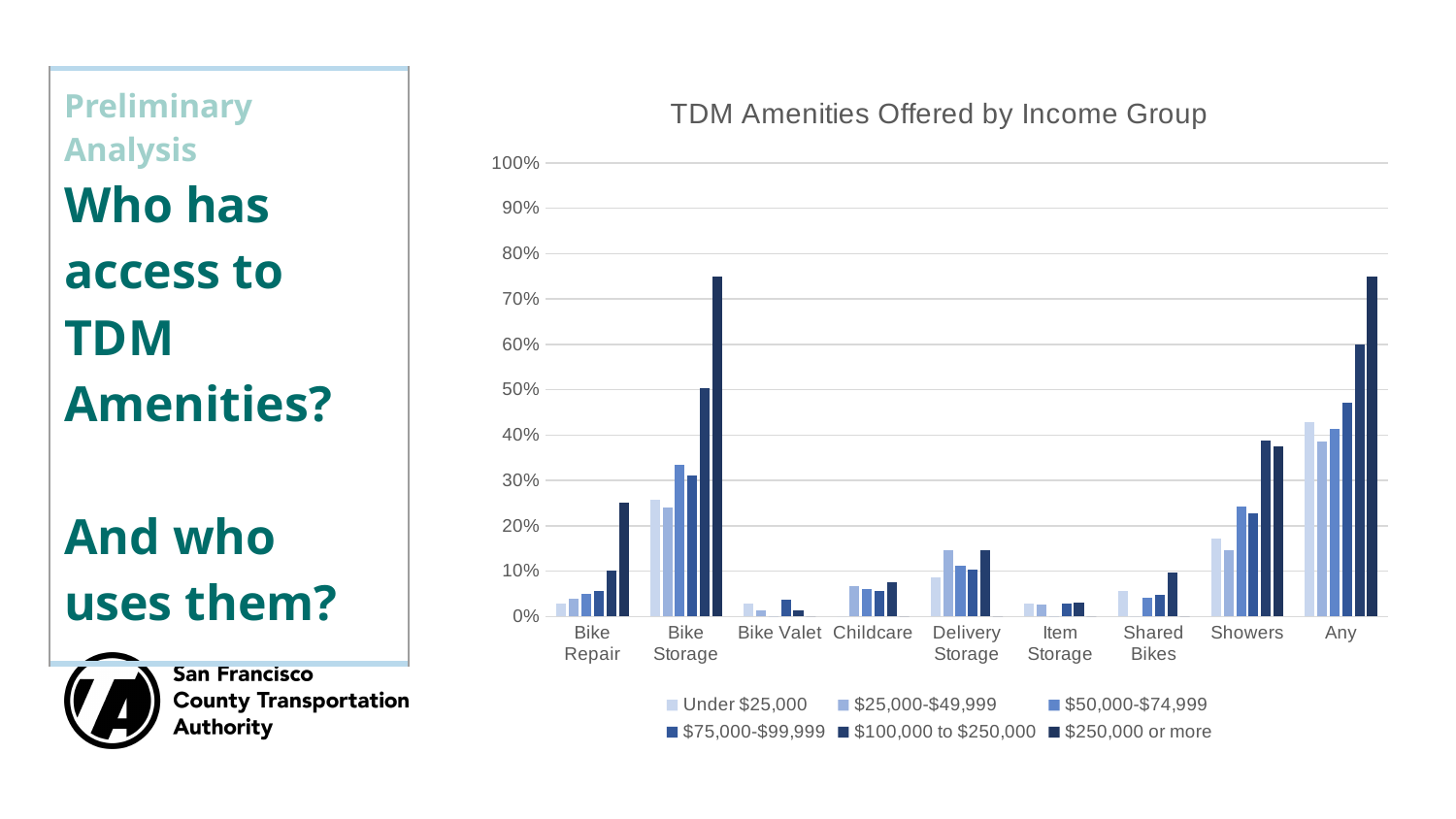
Which income group has the highest value for Any? $250,000 or more What is the title of the chart? TDM Amenities Offered by Income Group Is the value for Bike Valet in the Under $25,000 group greater or less than 10%? less Which income group has the highest value for Bike Storage? $250,000 or more How many income groups does the legend list? 6 For Bike Storage, which is larger: the $250,000 or more group or the $100,000 to $250,000 group? $250,000 or more Is the value for Delivery Storage in the $25,000-$49,999 group greater or less than 10%? greater For Any, which is larger: the Under $25,000 group or the $25,000-$49,999 group? Under $25,000 Is the value for Showers in the $100,000 to $250,000 group greater or less than 30%? greater What kind of chart is shown on the slide? bar chart How many amenity categories are shown on the x axis? 9